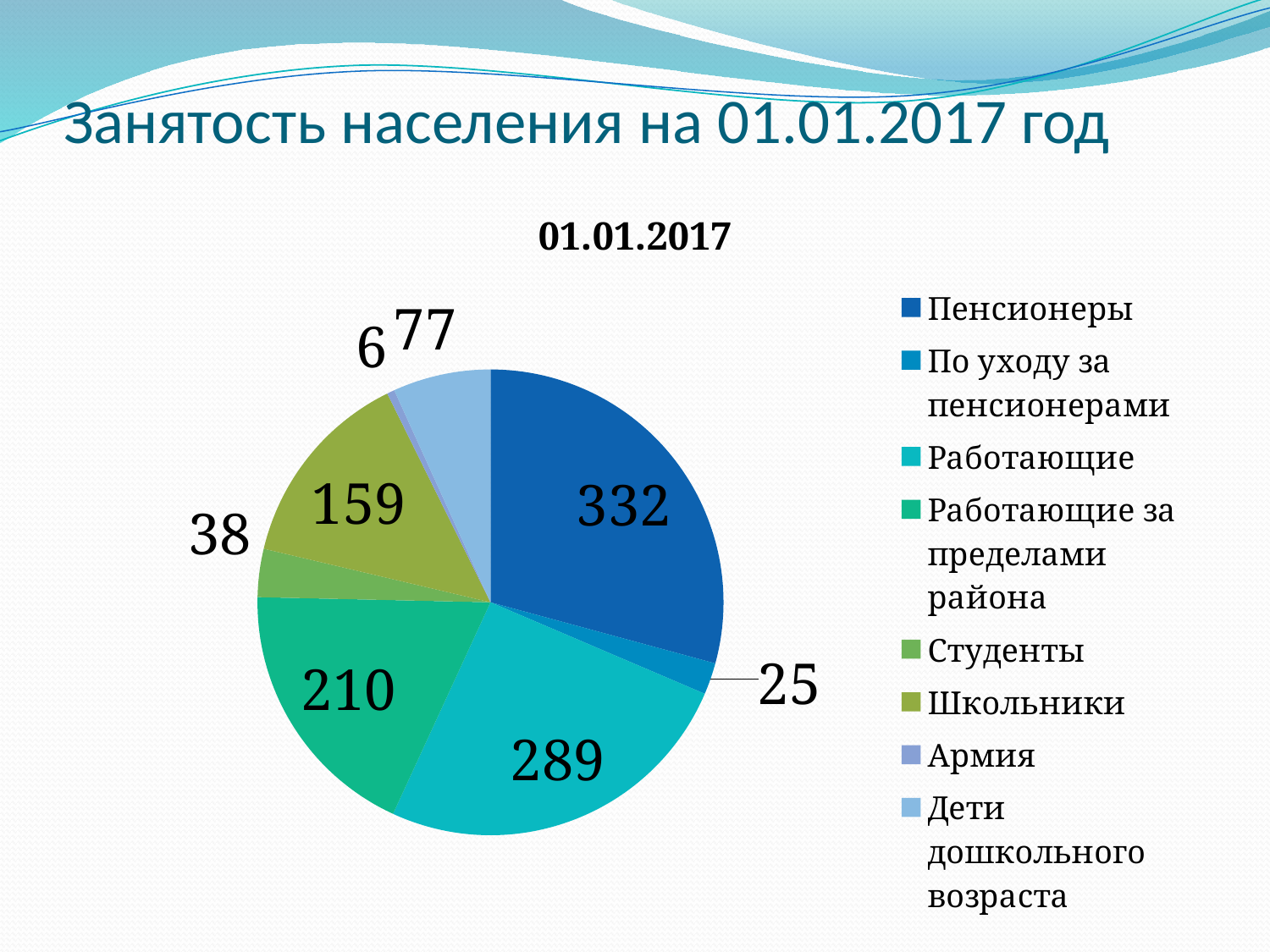
What is the value for Работающие? 289 How many categories does the pie chart have? 8 What kind of chart is shown on the slide? pie chart Which is larger, the value for Работающие за пределами района or the value for Школьники? Работающие за пределами района What is the difference between the values for Пенсионеры and Работающие? 43 What is the title of the chart? 01.01.2017 What is the value for Пенсионеры? 332 What is the value for Школьники? 159 What is the value for Армия? 6 Which category has the smallest slice of the pie? Армия What is the total of all the values shown in the pie chart? 1136 Which category has the largest slice of the pie? Пенсионеры